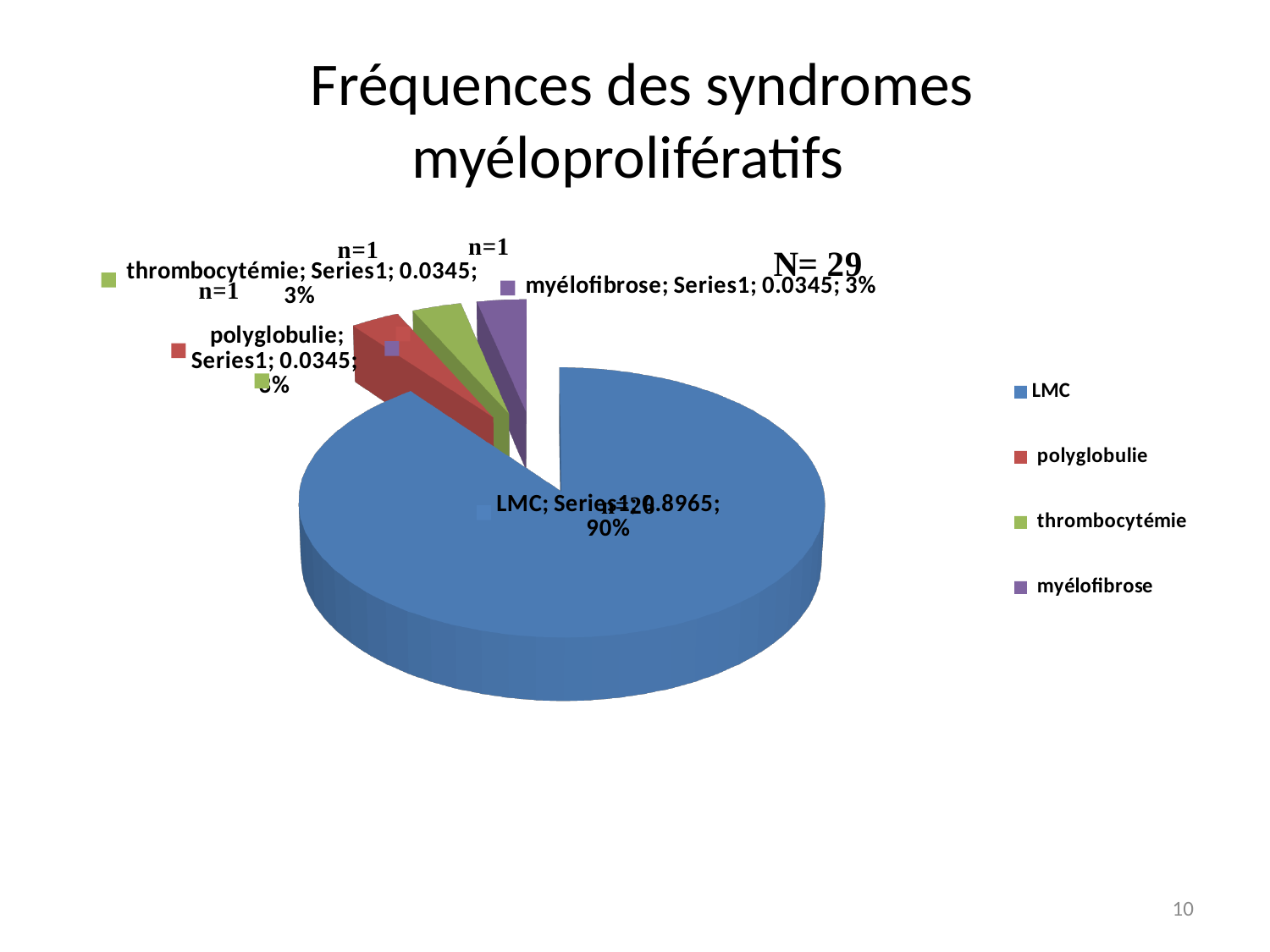
What kind of chart is shown on the slide? pie chart What is the title of the chart on the slide? Fréquences des syndromes myéloprolifératifs What share of the pie does thrombocytémie represent? 3% Which category has the largest slice of the pie? LMC What share of the pie does LMC represent? 90% What share of the pie does myélofibrose represent? 3% What is the difference in percentage points between the LMC share and the thrombocytémie share? 87 How many categories are shown in the pie chart? 4 What is the data label value shown for LMC? 0.8965 Which is larger, the share for LMC or the share for polyglobulie? LMC What is the data label value shown for myélofibrose? 0.0345